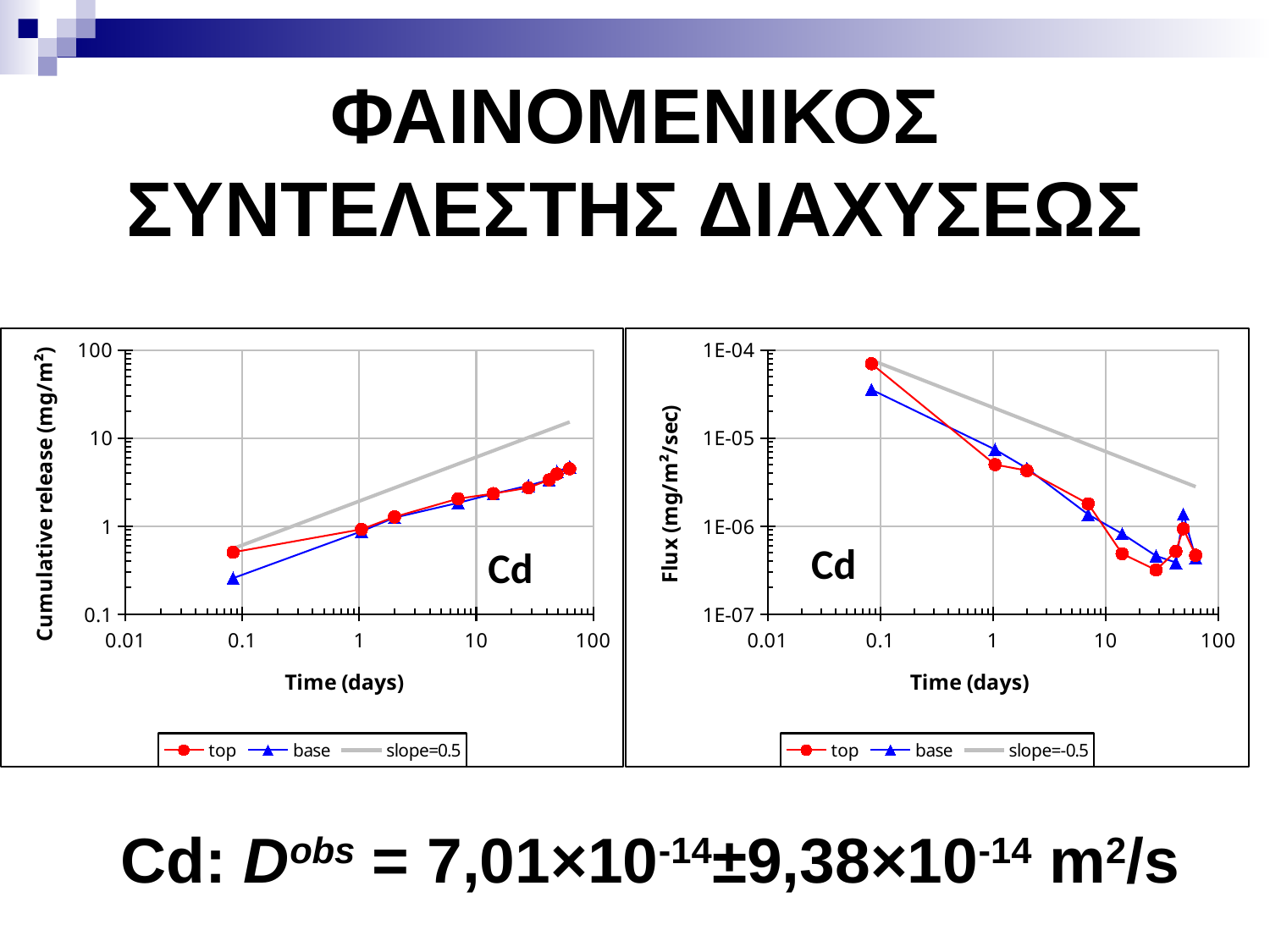
In the right chart (Flux), at the earliest time point, is the 'top' value or the 'base' value larger? top In the left chart (Cumulative release), is the 'top' value at the latest time point greater or less than 1? greater In the right chart (Flux), is the 'top' value at the earliest time point greater or less than 1E-05? greater In the right chart (Flux), is the 'top' value at the latest time point greater or less than 1E-06? less In the right chart (Flux), do the 'top' values rise or fall as time increases? fall What is the x-axis title of the left chart? Time (days) In the left chart (Cumulative release), at the earliest time point, is the 'top' value or the 'base' value larger? top In the left chart (Cumulative release), do the 'top' values rise or fall as time increases? rise What is the label of the grey reference line in the legend of the right chart (Flux)? slope=-0.5 How many series does the legend of the right chart (Flux vs Time) list? 3 What kind of chart is the left chart (Cumulative release vs Time)? line chart